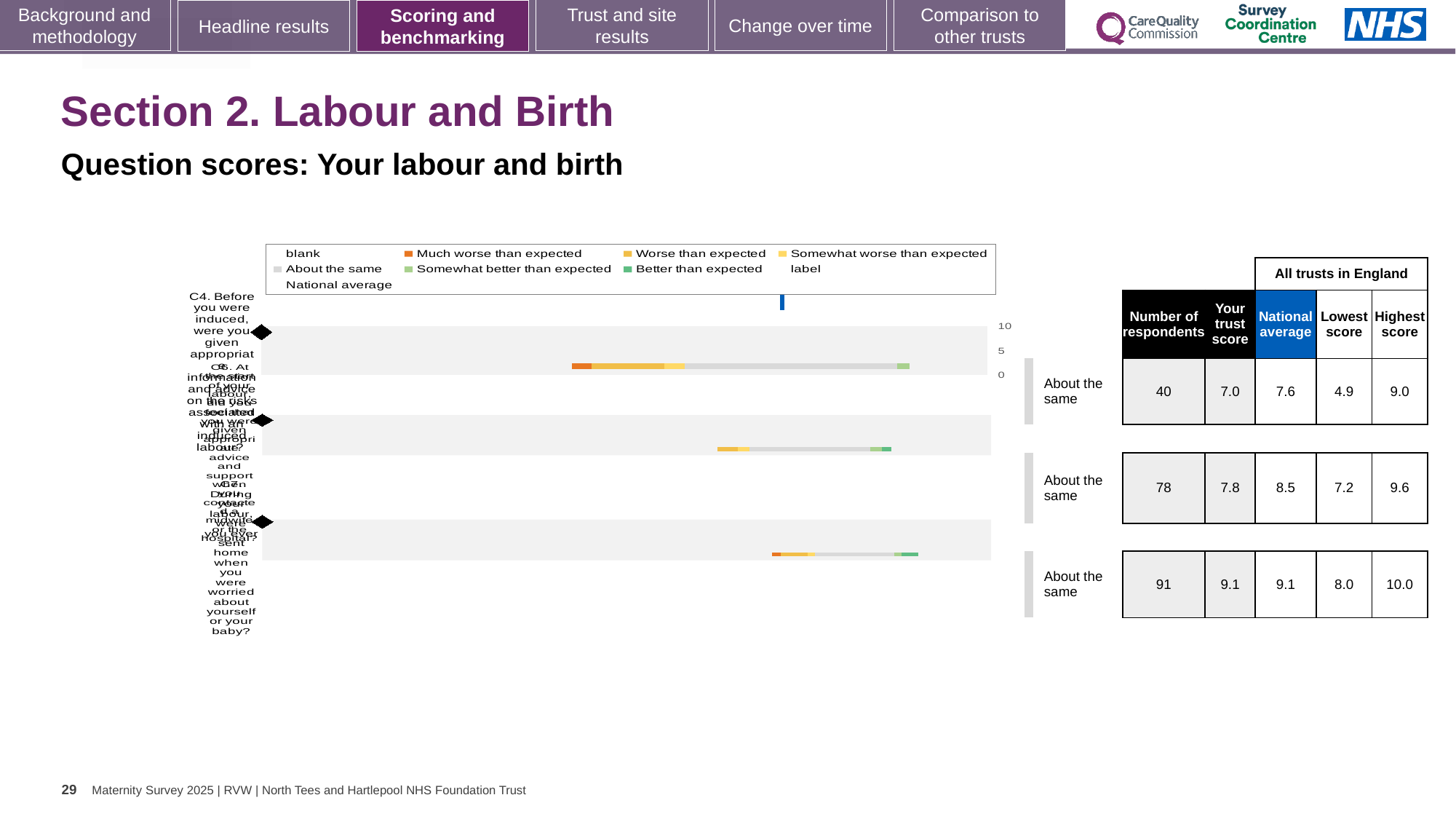
What colour represents 'Much worse than expected' in the legend? orange What kind of chart is shown on the slide? bar chart In the table, what is the trust score for the first row (C4)? 7.0 Which row of the table has the highest number of respondents? the third row (91) In the table, what is the highest score for the third row? 10.0 In the first row of the table, which is larger: the trust score or the national average? the national average (7.6) How many question rows (bars) does the chart show? 3 In the table, what is the national average for the second row? 8.5 Which row of the table has the lowest 'Lowest score'? the first row (4.9) In the table, what is the number of respondents for the first row (C4)? 40 What benchmark category is shown for all three rows? About the same What is the difference between the national average and the trust score in the second row of the table? 0.7